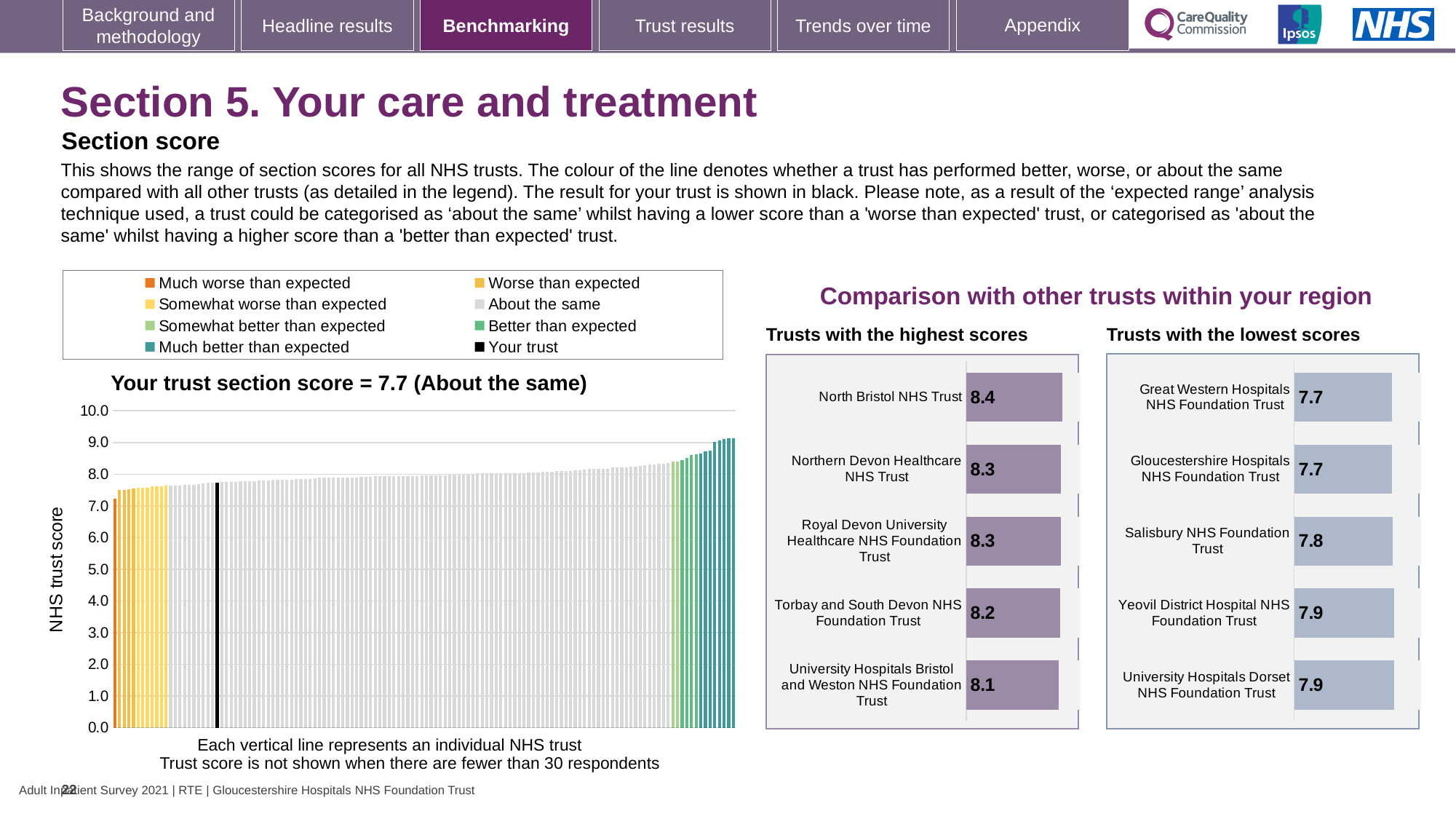
In the 'Trusts with the lowest scores' chart, which has the higher score: Yeovil District Hospital NHS Foundation Trust or Great Western Hospitals NHS Foundation Trust? Yeovil District Hospital NHS Foundation Trust In the 'Your trust section score' chart, is the value of the leftmost (lowest) bar greater or less than 8.0? less In the 'Trusts with the highest scores' chart, what is the difference between the scores of North Bristol NHS Trust and University Hospitals Bristol and Weston NHS Foundation Trust? 0.3 How many trusts are shown in the 'Trusts with the lowest scores' chart? 5 How many entries does the legend above the 'Your trust section score' chart list? 8 In the 'Your trust section score' chart, what is the section score for your trust? 7.7 What kind of chart is the 'Your trust section score' chart? bar chart What is the y-axis label of the 'Your trust section score' chart? NHS trust score In the 'Your trust section score' chart, do the bars rise or fall from left to right? rise In the 'Trusts with the highest scores' chart, what is the score for Torbay and South Devon NHS Foundation Trust? 8.2 In the 'Trusts with the lowest scores' chart, what is the score for Salisbury NHS Foundation Trust? 7.8 In the 'Trusts with the highest scores' chart, which trust has the highest score? North Bristol NHS Trust